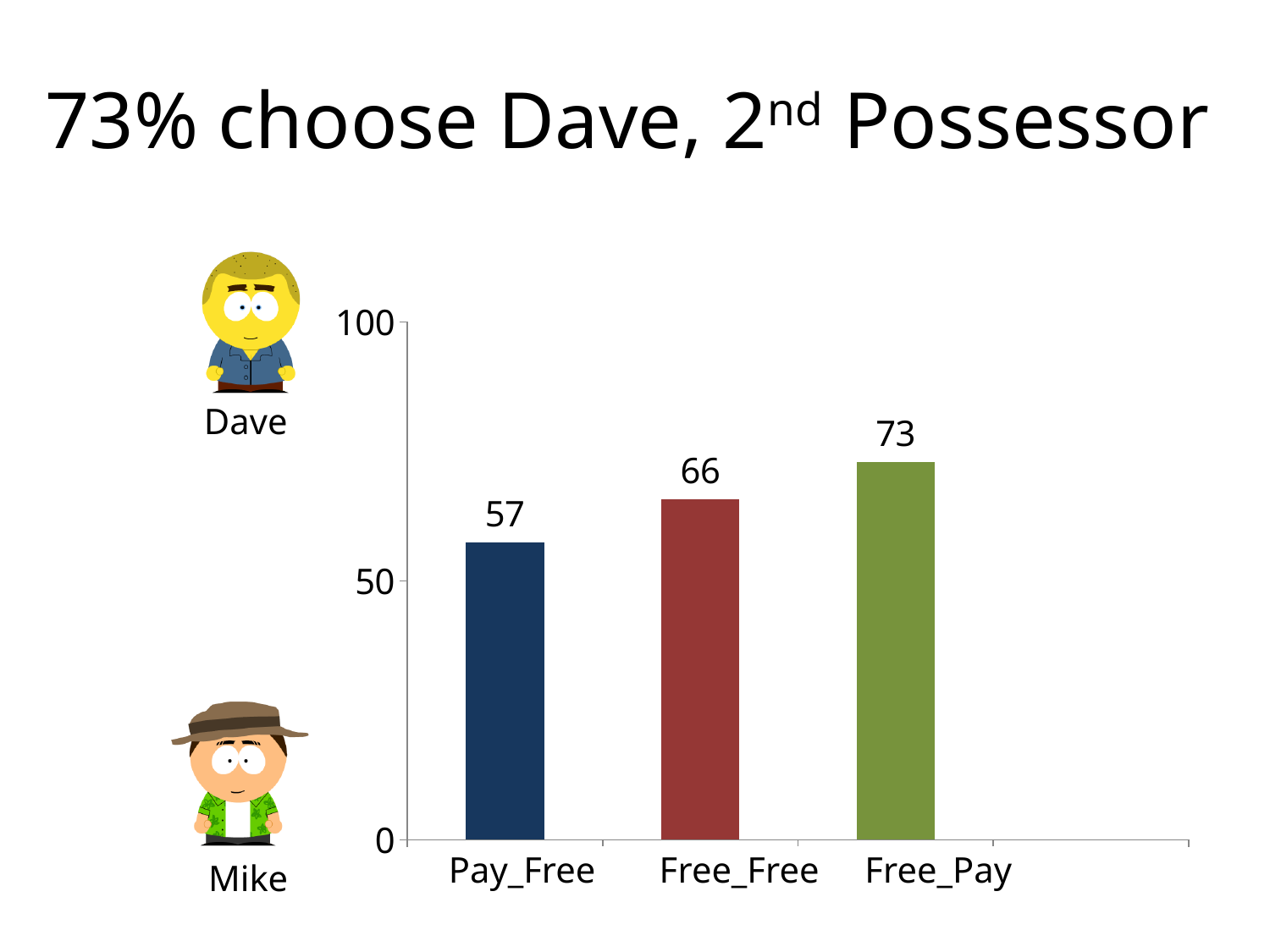
How many categories are shown on the x axis? 3 What is the difference between the values for Free_Free and Pay_Free? 9 What is the difference between the values for Free_Pay and Pay_Free? 16 What is the value for Free_Free? 66 Which category has the lowest value? Pay_Free Is the value for Free_Pay greater or less than 50? greater What is the value for Free_Pay? 73 Do the values rise or fall from Pay_Free to Free_Pay along the x axis? rise What kind of chart is shown on the slide? bar chart What is the value for Pay_Free? 57 Which is larger, the value for Free_Free or the value for Pay_Free? Free_Free Which category has the highest value? Free_Pay